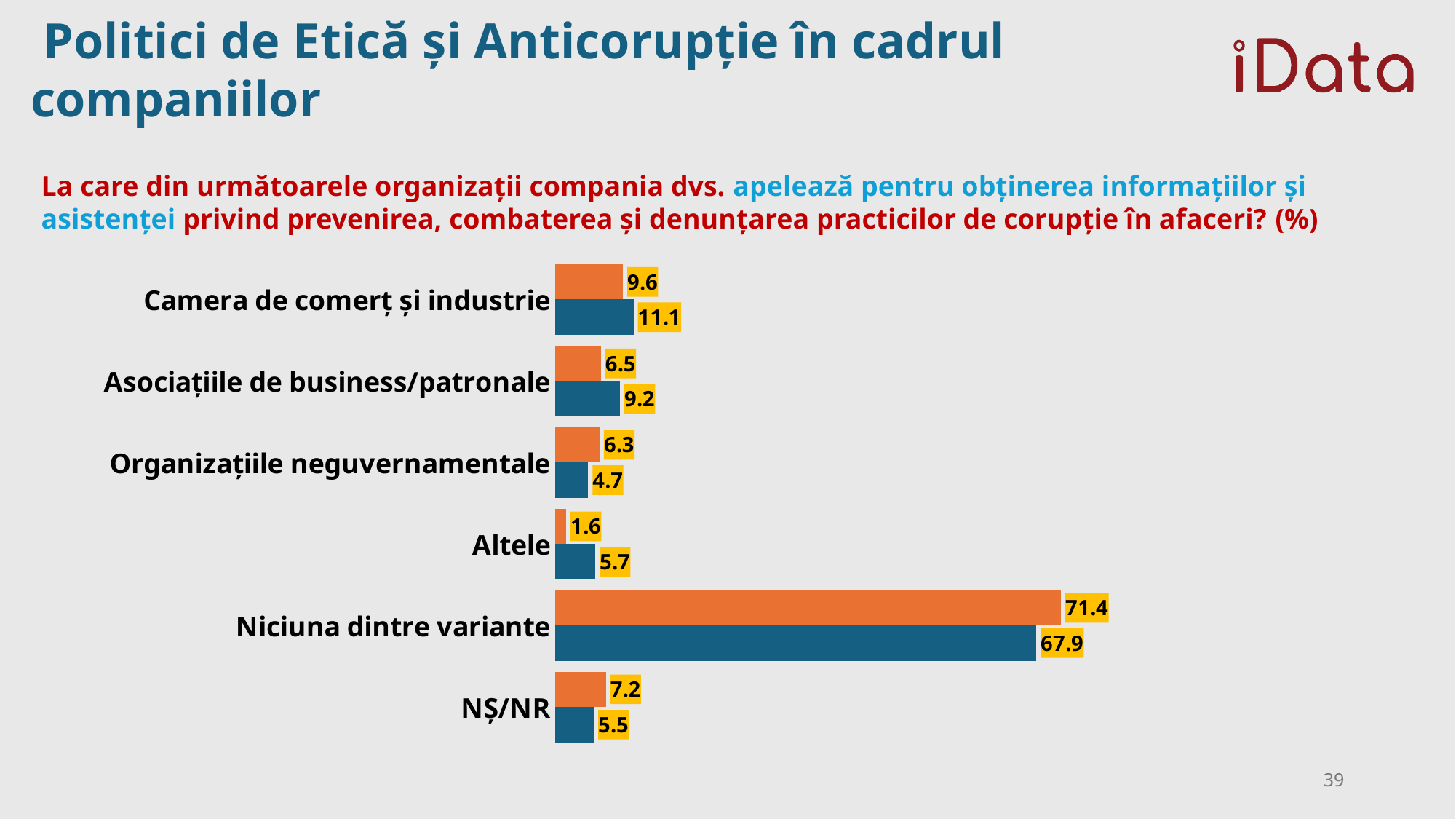
What type of chart is shown on the slide? bar chart Which category has the lowest orange bar value? Altele What is the value of the orange bar for "NȘ/NR"? 7.2 What is the difference between the orange and blue bar values for "Niciuna dintre variante"? 3.5 For "Altele", which bar is larger, the orange or the blue one? blue What is the value of the orange bar for "Camera de comerț și industrie"? 9.6 What is the value of the blue bar for "Organizațiile neguvernamentale"? 4.7 Which category has the lowest blue bar value? Organizațiile neguvernamentale How many categories are shown on the chart? 6 Which category has the highest orange bar value? Niciuna dintre variante What is the value of the blue bar for "Asociațiile de business/patronale"? 9.2 What is the difference between the blue bar values for "Camera de comerț și industrie" and "Altele"? 5.4